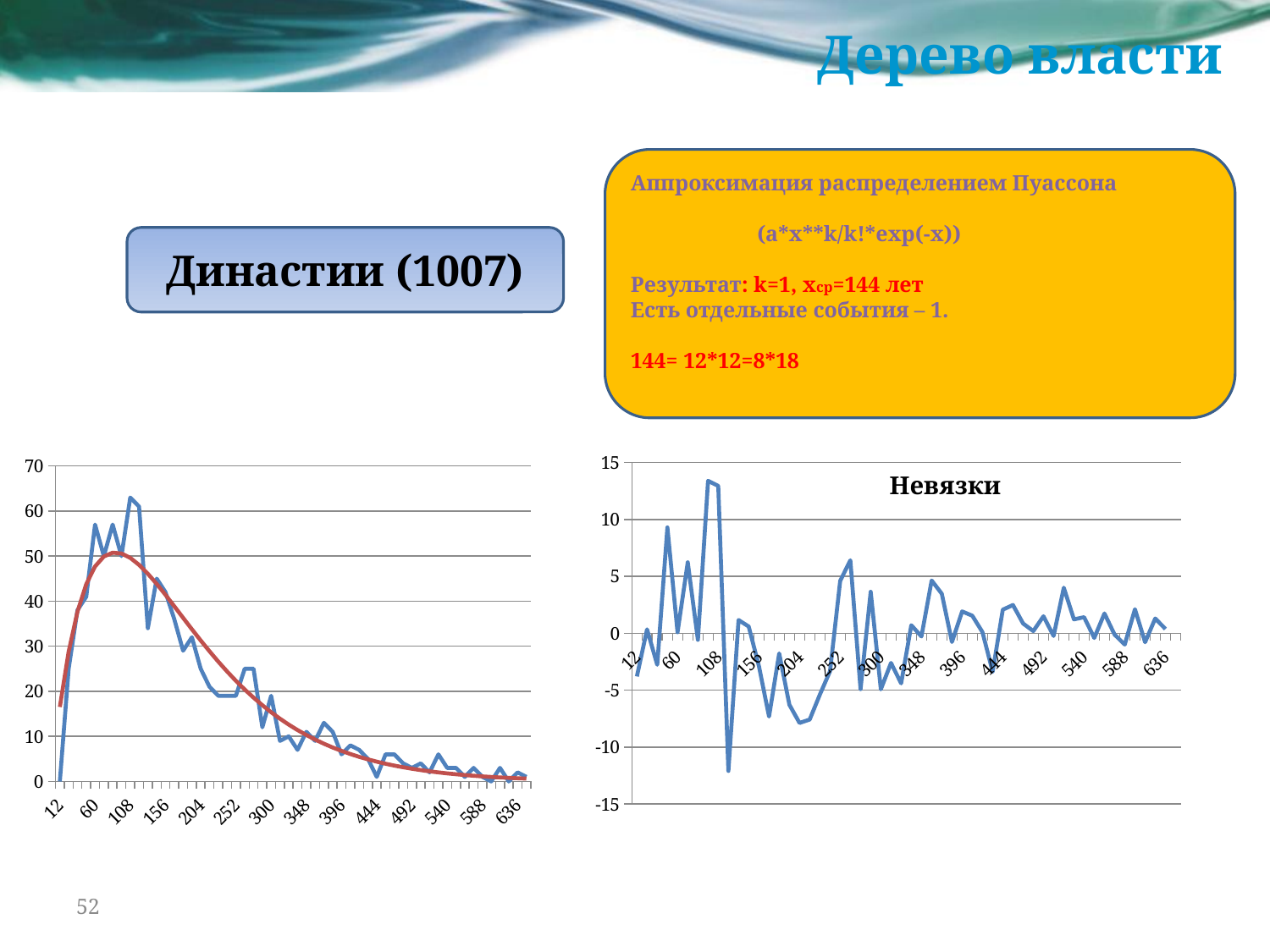
What is the title of the right chart? Невязки In the left chart, is the value of the red curve at x = 108 greater or less than 40? greater In the left chart, is the highest value of the blue line greater or less than 50? greater In the right chart "Невязки", is the highest value greater or less than 10? greater What kind of chart is the left chart on the slide? line chart How many tick labels are shown on the x axis of the left chart? 14 How many lines are plotted in the left chart? 2 In the left chart, do the values of the blue line generally rise or fall between x = 108 and x = 636? fall What kind of chart is the right chart titled "Невязки"? line chart What is the maximum value shown on the y axis of the left chart? 70